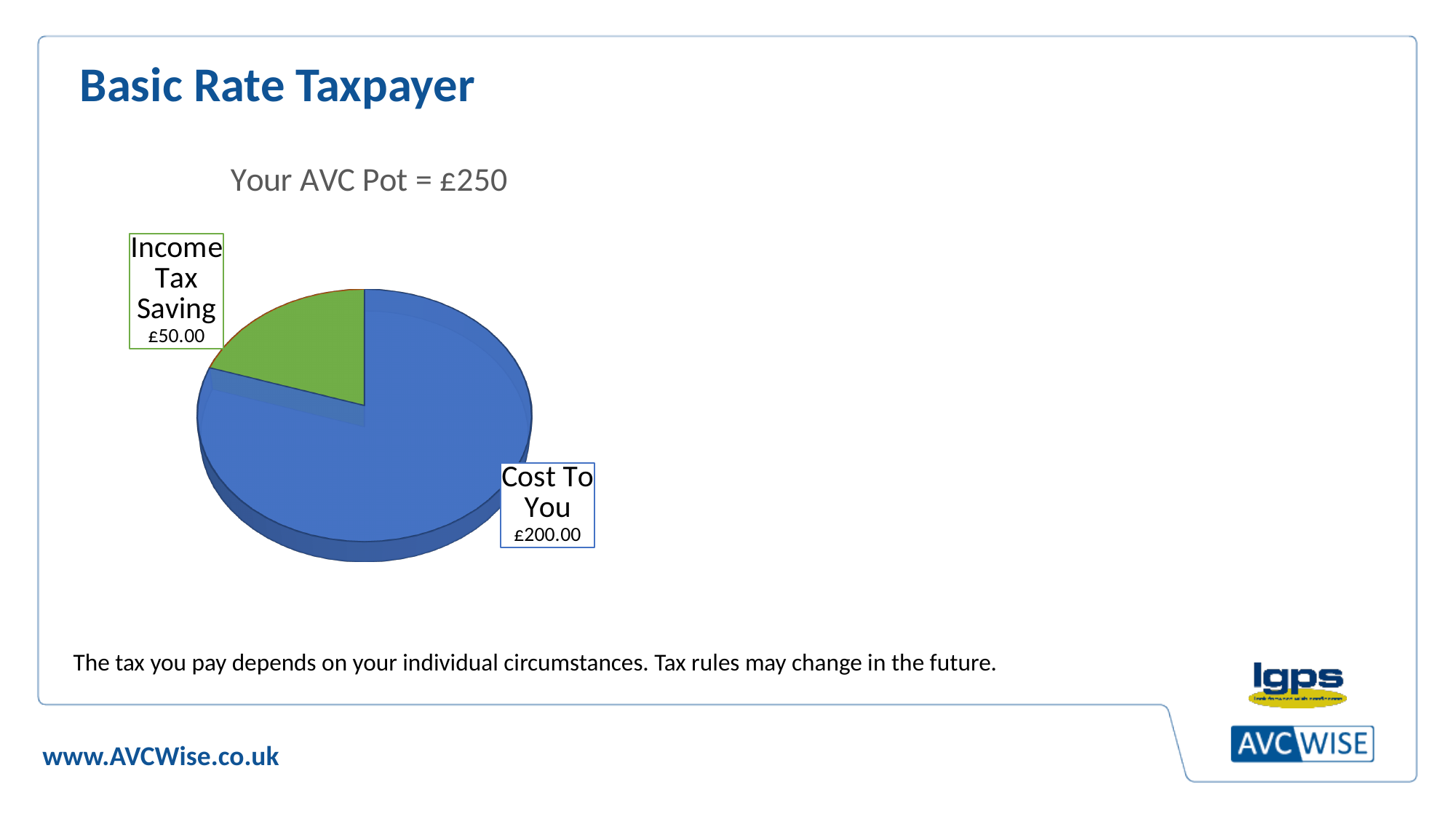
What is the title of the chart? Your AVC Pot = £250 What kind of chart is shown on the slide? Pie chart Which is larger, Cost To You or Income Tax Saving? Cost To You How many slices does the pie chart have? 2 Which slice is the largest? Cost To You What is the value of the Cost To You slice? £200.00 What share of the pie does the Cost To You slice represent? 80% What colour is the Income Tax Saving slice? Green Which slice is the smallest? Income Tax Saving What is the difference between the Cost To You and Income Tax Saving values? £150.00 What is the value of the Income Tax Saving slice? £50.00 What share of the pie does the Income Tax Saving slice represent? 20%